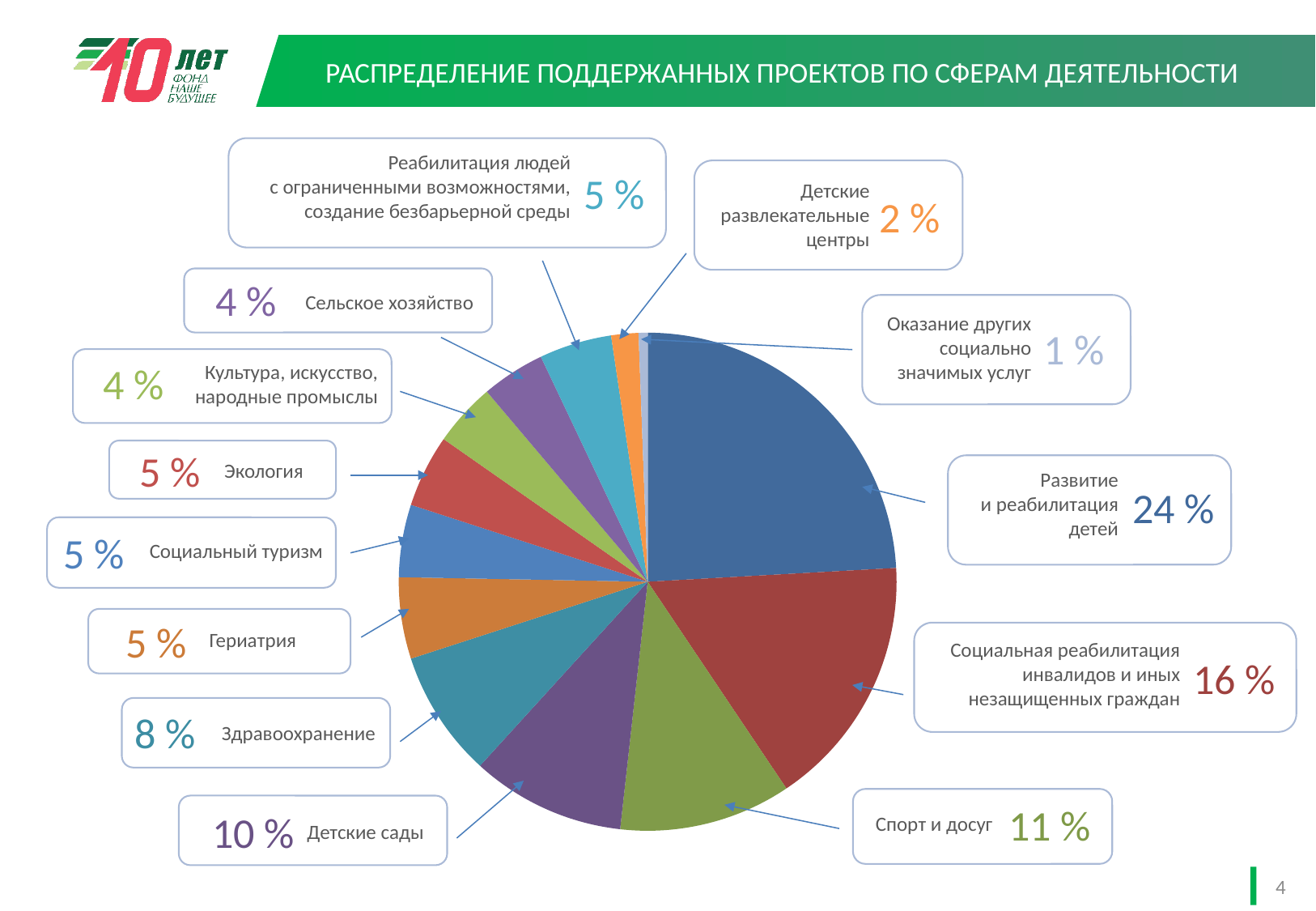
Which category has the largest share of the pie? Развитие и реабилитация детей How many categories are shown in the pie chart? 13 What is the difference in percentage points between "Развитие и реабилитация детей" and "Социальная реабилитация инвалидов и иных незащищенных граждан"? 8 % What is the combined share of "Спорт и досуг" and "Детские сады"? 21 % What share of supported projects is in the category "Развитие и реабилитация детей"? 24 % Which category has the smallest share of the pie? Оказание других социально значимых услуг Which has a larger share: "Детские сады" or "Здравоохранение"? Детские сады What is the title of the chart on the slide? РАСПРЕДЕЛЕНИЕ ПОДДЕРЖАННЫХ ПРОЕКТОВ ПО СФЕРАМ ДЕЯТЕЛЬНОСТИ What percentage is shown for "Здравоохранение"? 8 % What percentage is shown for "Спорт и досуг"? 11 % What kind of chart is shown on the slide? pie chart What percentage is shown for "Детские развлекательные центры"? 2 %